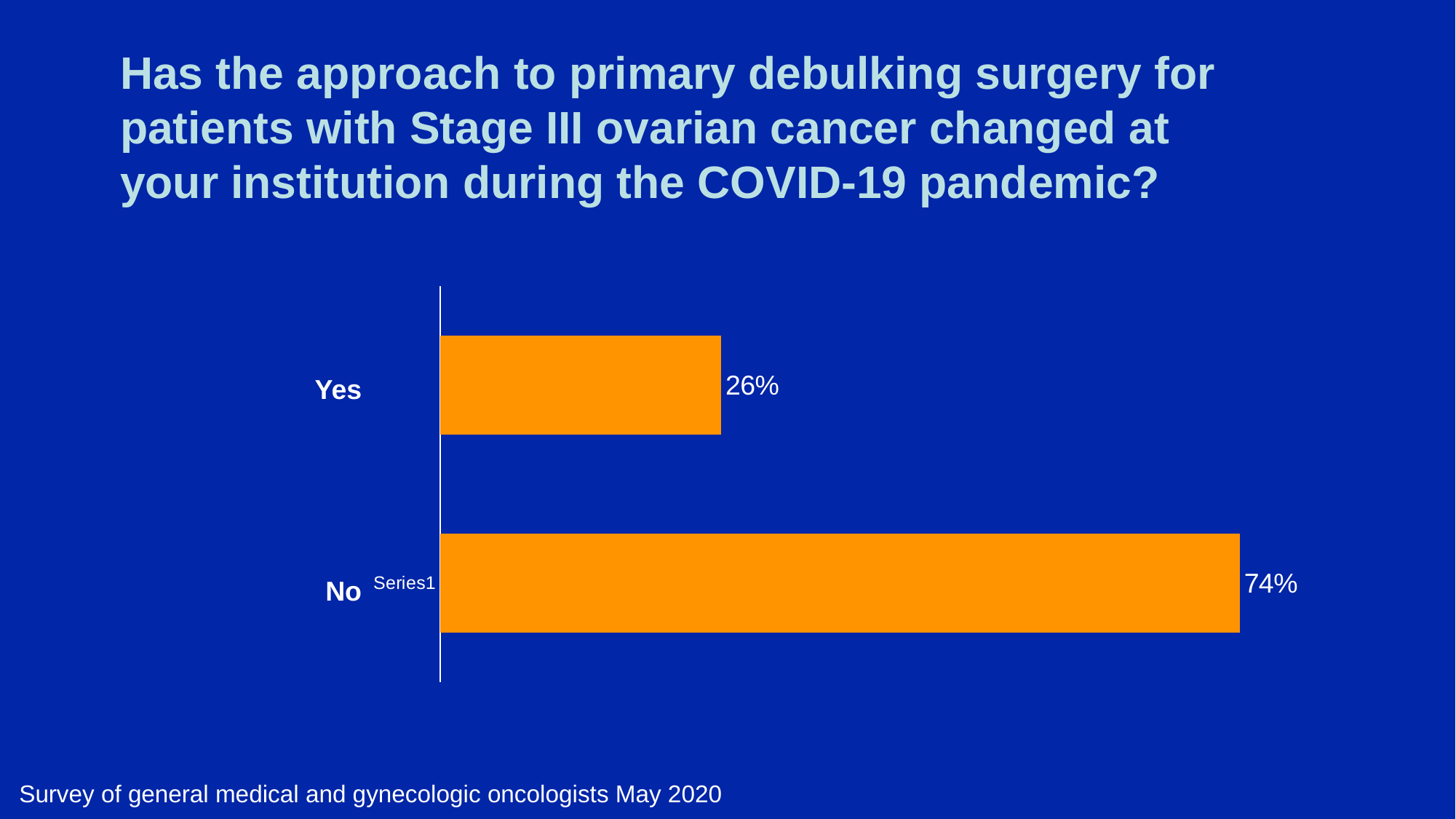
What kind of chart is shown on the slide? Bar chart What percentage of respondents answered No? 74% Which response category has the lowest value? Yes What colour are the bars in the chart? Orange What is the difference in percentage points between the No and Yes responses? 48 How many response categories are shown in the chart? 2 Which is larger, the value for Yes or the value for No? No What percentage of respondents answered Yes? 26% According to the footnote, who was surveyed and when? General medical and gynecologic oncologists, May 2020 What is the total of the Yes and No percentages? 100% Which response category has the highest value? No